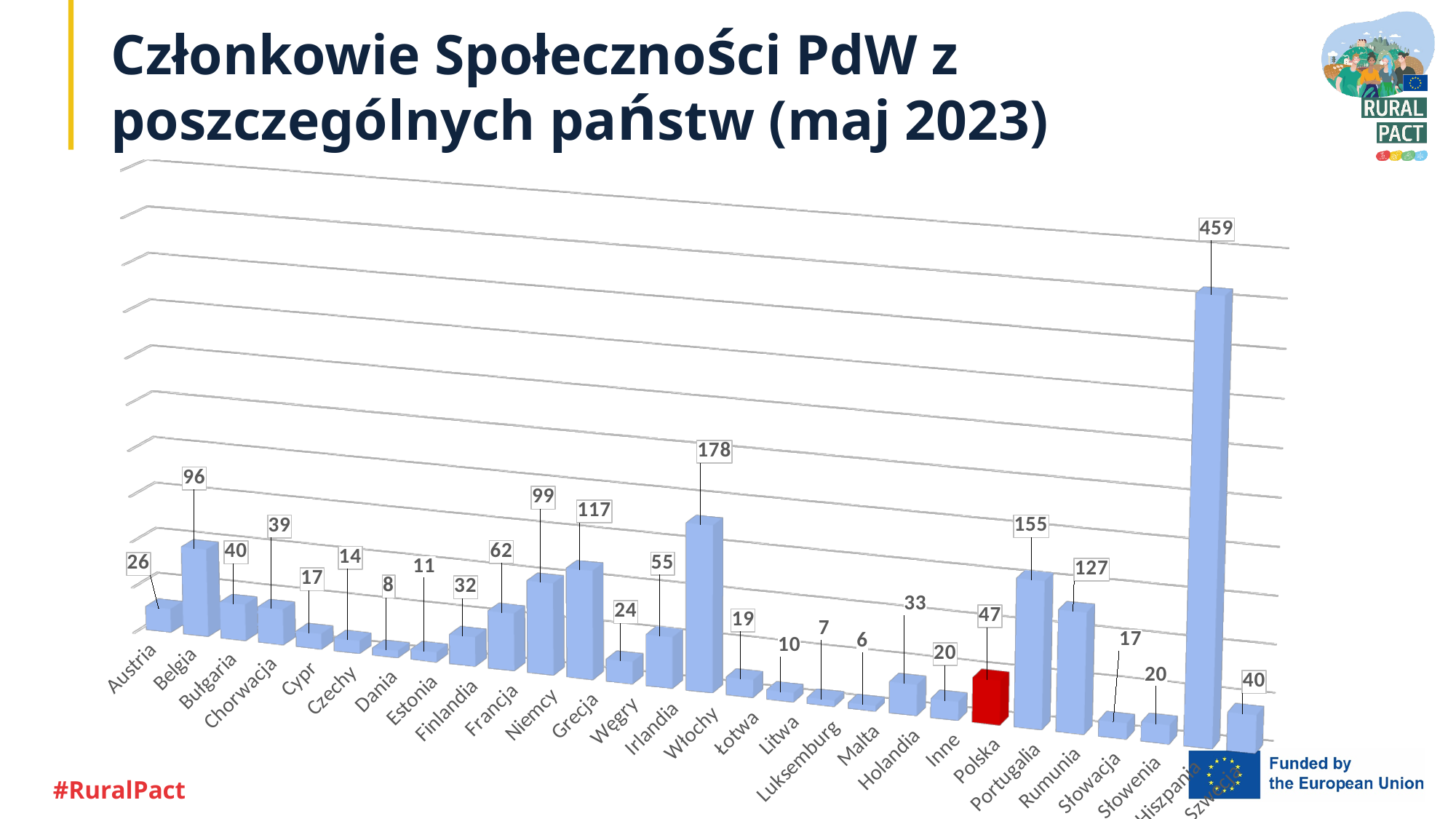
What is the difference between the values for Portugalia and Rumunia? 28 What is the value for Niemcy? 99 Which country has the highest value? Hiszpania What is the difference between the values for Hiszpania and Włochy? 281 Which is larger, the value for Grecja or the value for Irlandia? Grecja What is the value for Polska? 47 Which is larger, the value for Belgia or the value for Francja? Belgia Which bar is coloured red instead of blue? Polska Which country has the lowest value? Malta What kind of chart is shown on the slide? bar chart What is the value for Włochy? 178 How many categories are shown on the chart? 28